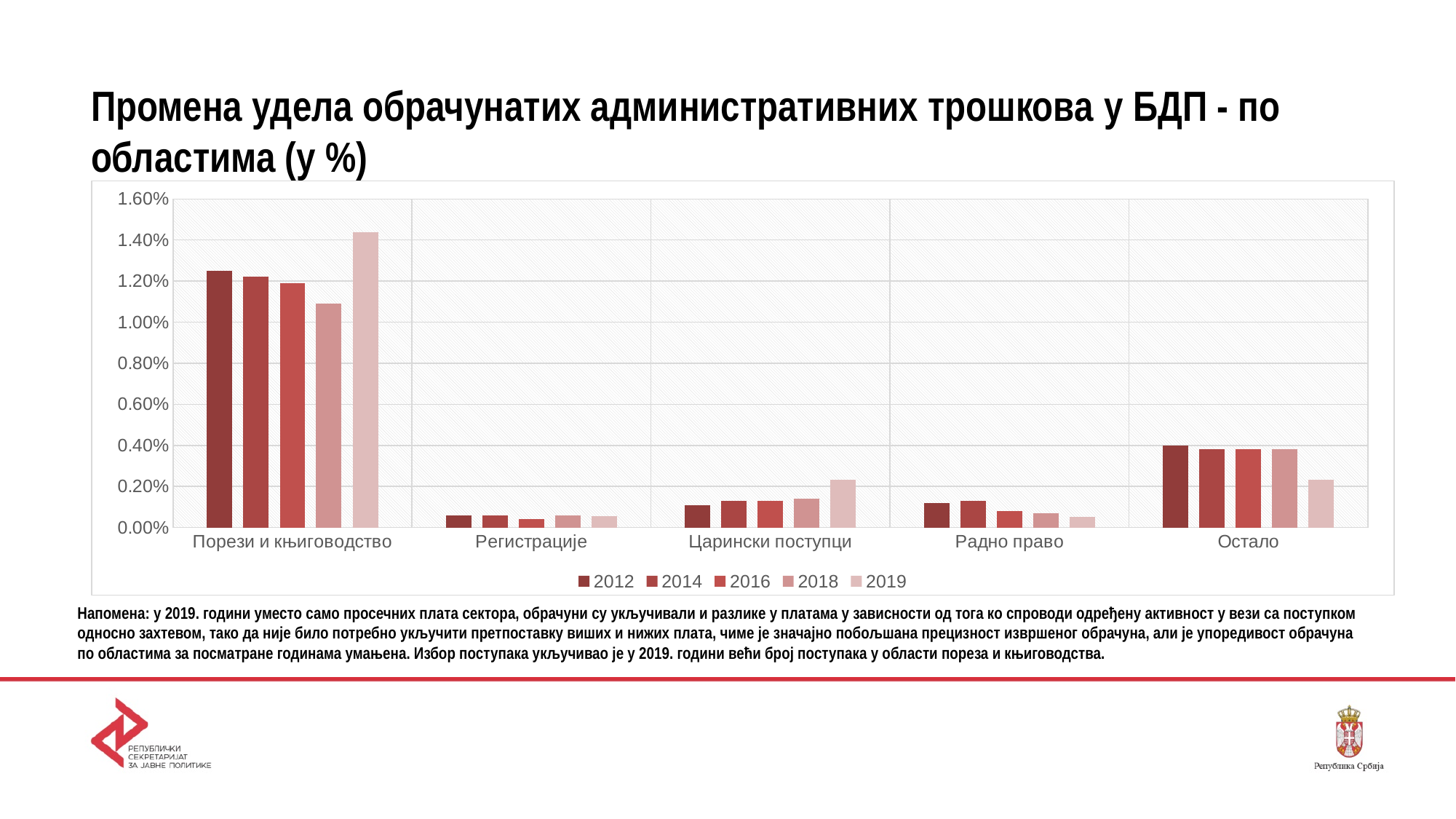
For Радно право, do the values rise or fall from 2014 to 2019? fall How many categories are shown on the x axis of the chart? 5 Which year has the lowest value within the Порези и књиговодство category? 2018 Is the 2012 value for Остало greater or less than 0.20%? greater For Остало, which is larger: the 2012 value or the 2019 value? 2012 For Царински поступци, which is larger: the 2012 value or the 2019 value? 2019 How many series does the legend list? 5 Which category has the highest value for 2019? Порези и књиговодство Is the 2018 value for Порези и књиговодство greater or less than 1.20%? less What kind of chart is shown on the slide? bar chart Is the 2019 value for Порези и књиговодство greater or less than 1.20%? greater Which category has the lowest value for 2012? Регистрације